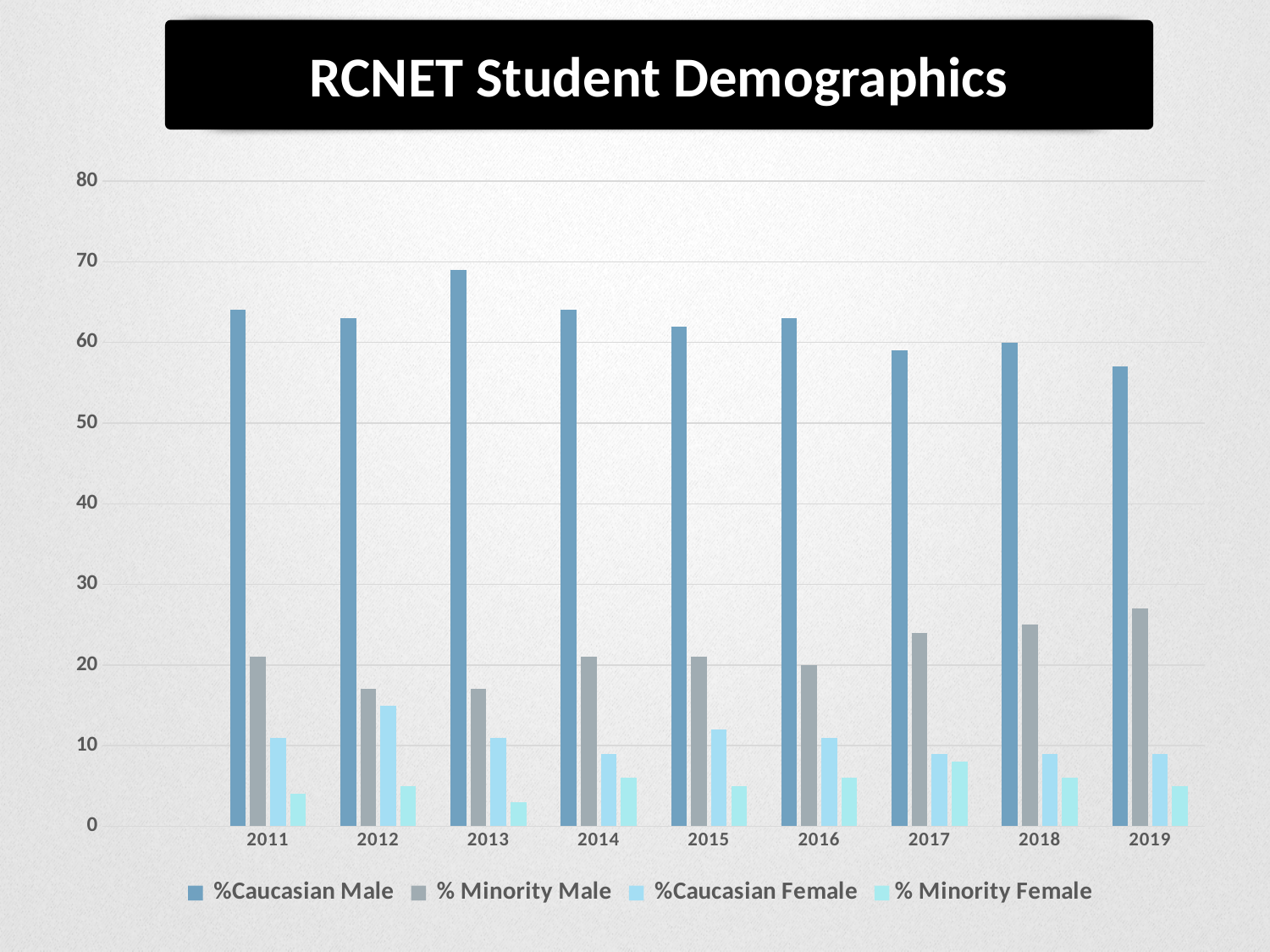
How many years are shown on the x axis? 9 In which year is the %Caucasian Male value highest? 2013 In which year is the %Caucasian Female value highest? 2012 Is the % Minority Female value for 2011 greater or less than 10? less In which year is the % Minority Male value highest? 2019 In which year is the %Caucasian Male value lowest? 2019 What kind of chart is shown on the slide? bar chart Does the % Minority Male value rise or fall from 2016 to 2019? rise Is the %Caucasian Male value for 2013 greater or less than 60? greater Which is larger, the % Minority Male value for 2019 or for 2012? 2019 How many series does the legend list? 4 Is the % Minority Male value for 2019 greater or less than 20? greater